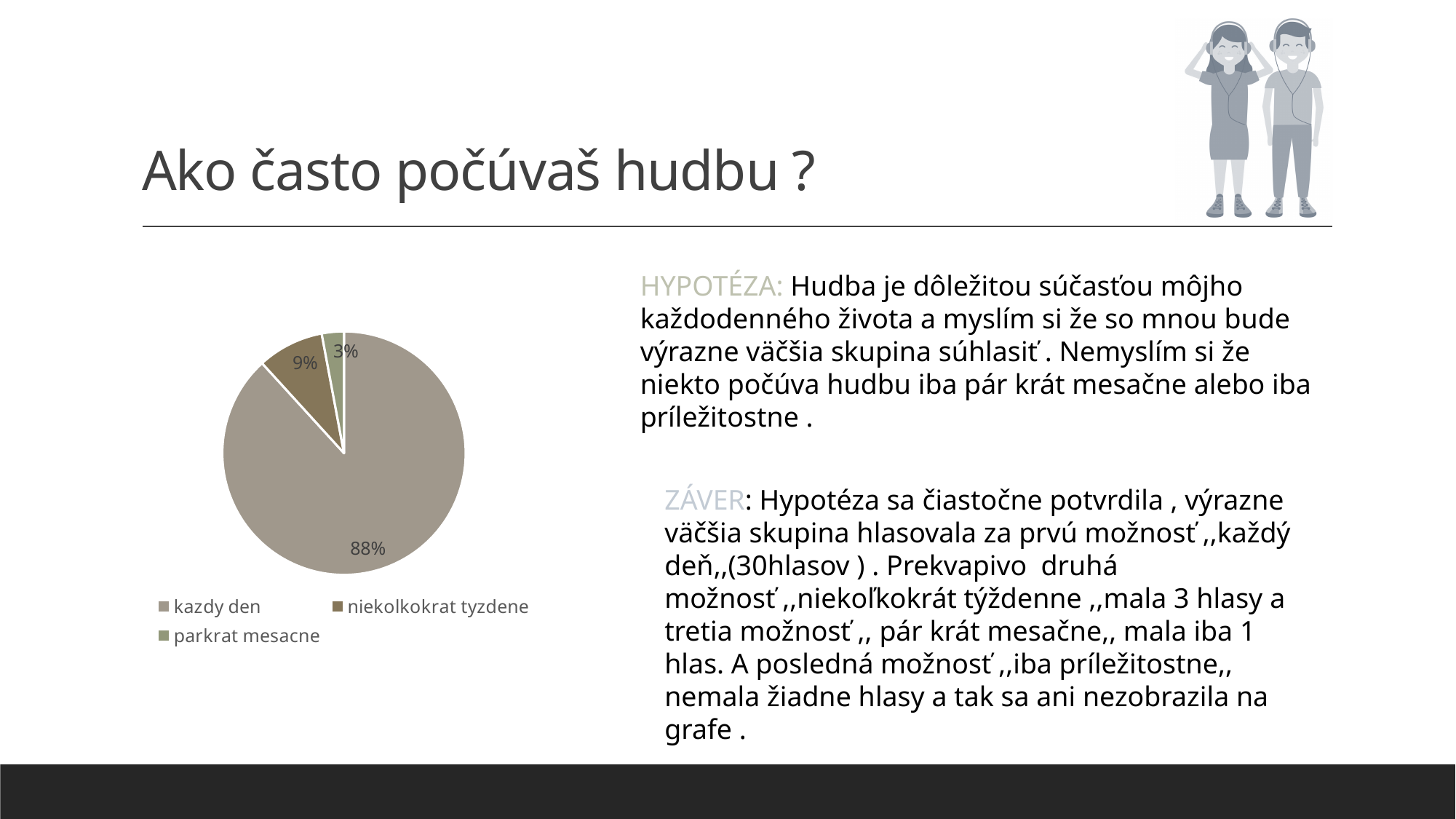
What is the title of the slide containing the pie chart? Ako často počúvaš hudbu ? How many categories does the pie chart legend list? 3 What is the difference in percentage points between 'kazdy den' and 'niekolkokrat tyzdene'? 79 Which is larger, the slice for 'niekolkokrat tyzdene' or the slice for 'parkrat mesacne'? niekolkokrat tyzdene Which category has the largest slice of the pie? kazdy den What kind of chart is shown on the slide? pie chart What is the difference in percentage points between 'niekolkokrat tyzdene' and 'parkrat mesacne'? 6 What share of the pie does 'niekolkokrat tyzdene' have? 9% Which category has the smallest slice of the pie? parkrat mesacne Is the share for 'kazdy den' greater or less than 50%? greater What share of the pie does 'kazdy den' have? 88% What share of the pie does 'parkrat mesacne' have? 3%